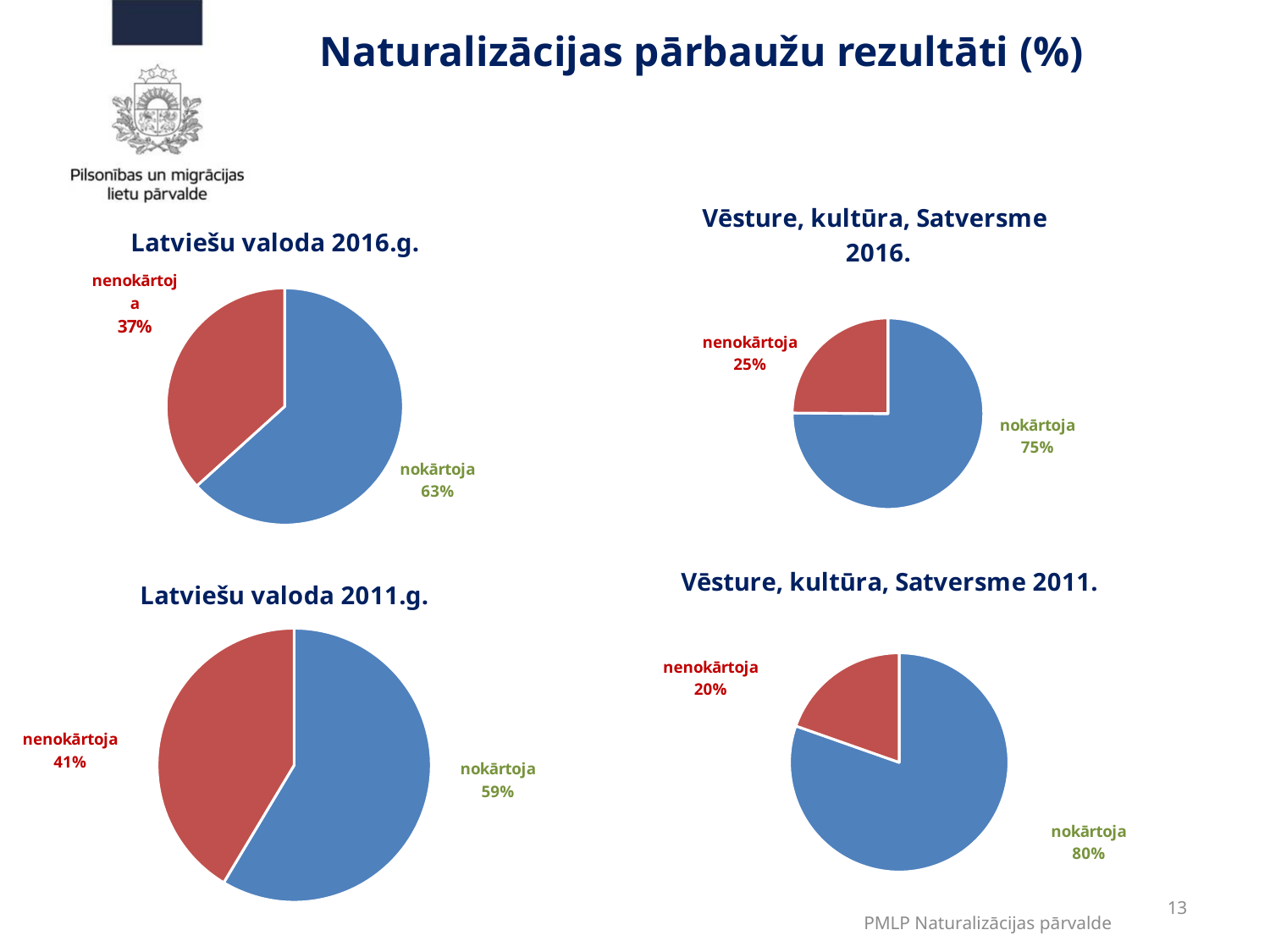
In the 'Latviešu valoda 2011.g.' chart, what share is labelled 'nokārtoja'? 59% In the 'Latviešu valoda 2016.g.' chart, what share is labelled 'nenokārtoja'? 37% In the 'Vēsture, kultūra, Satversme 2016.' chart, what is the difference between the 'nokārtoja' and 'nenokārtoja' shares? 50% What kind of chart is 'Latviešu valoda 2016.g.'? pie chart In the 'Latviešu valoda 2016.g.' chart, what share is labelled 'nokārtoja'? 63% How many pie charts are shown on the slide? 4 In the 'Vēsture, kultūra, Satversme 2011.' chart, what share is labelled 'nokārtoja'? 80% In the 'Latviešu valoda 2016.g.' chart, what is the difference between the 'nokārtoja' and 'nenokārtoja' shares? 26% How many slices does the 'Vēsture, kultūra, Satversme 2011.' chart have? 2 In the 'Latviešu valoda 2011.g.' chart, which slice is larger, 'nokārtoja' or 'nenokārtoja'? nokārtoja Which chart on the slide has the smallest 'nenokārtoja' share? Vēsture, kultūra, Satversme 2011. In the 'Vēsture, kultūra, Satversme 2016.' chart, what share is labelled 'nenokārtoja'? 25%